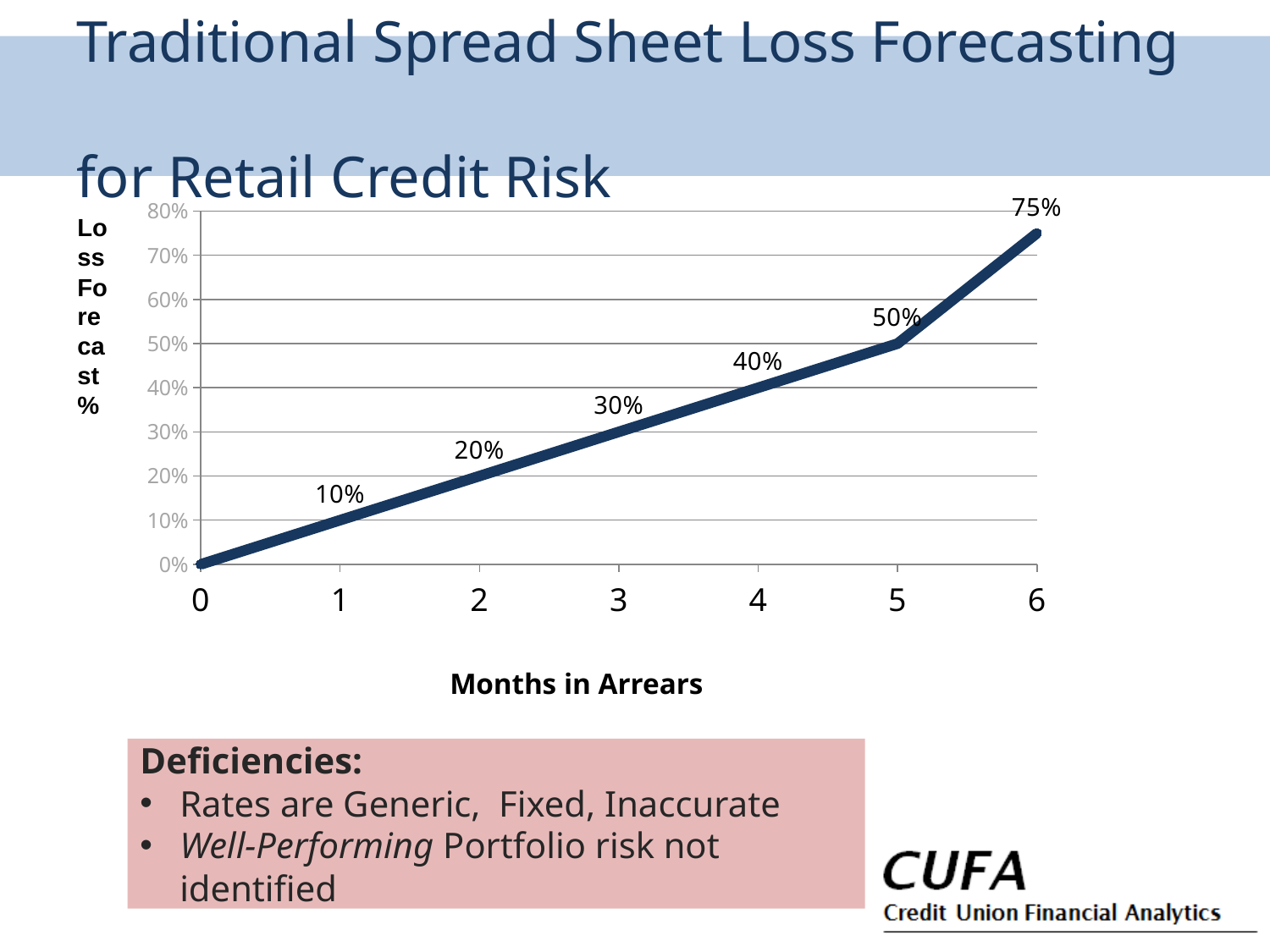
At how many months in arrears is the loss forecast lowest? 0 What is the difference between the loss forecast at 6 months and at 5 months in arrears? 25% What is the loss forecast at 1 month in arrears? 10% Which is larger, the loss forecast at 2 months or at 4 months in arrears? 4 months How many data points are plotted on the line? 7 What is the difference between the loss forecast at 4 months and at 2 months in arrears? 20% Does the loss forecast rise or fall as months in arrears increase? Rise What is the loss forecast at 3 months in arrears? 30% What is the loss forecast at 6 months in arrears? 75% What kind of chart is shown on the slide? Line chart What is the loss forecast at 5 months in arrears? 50% At how many months in arrears is the loss forecast highest? 6